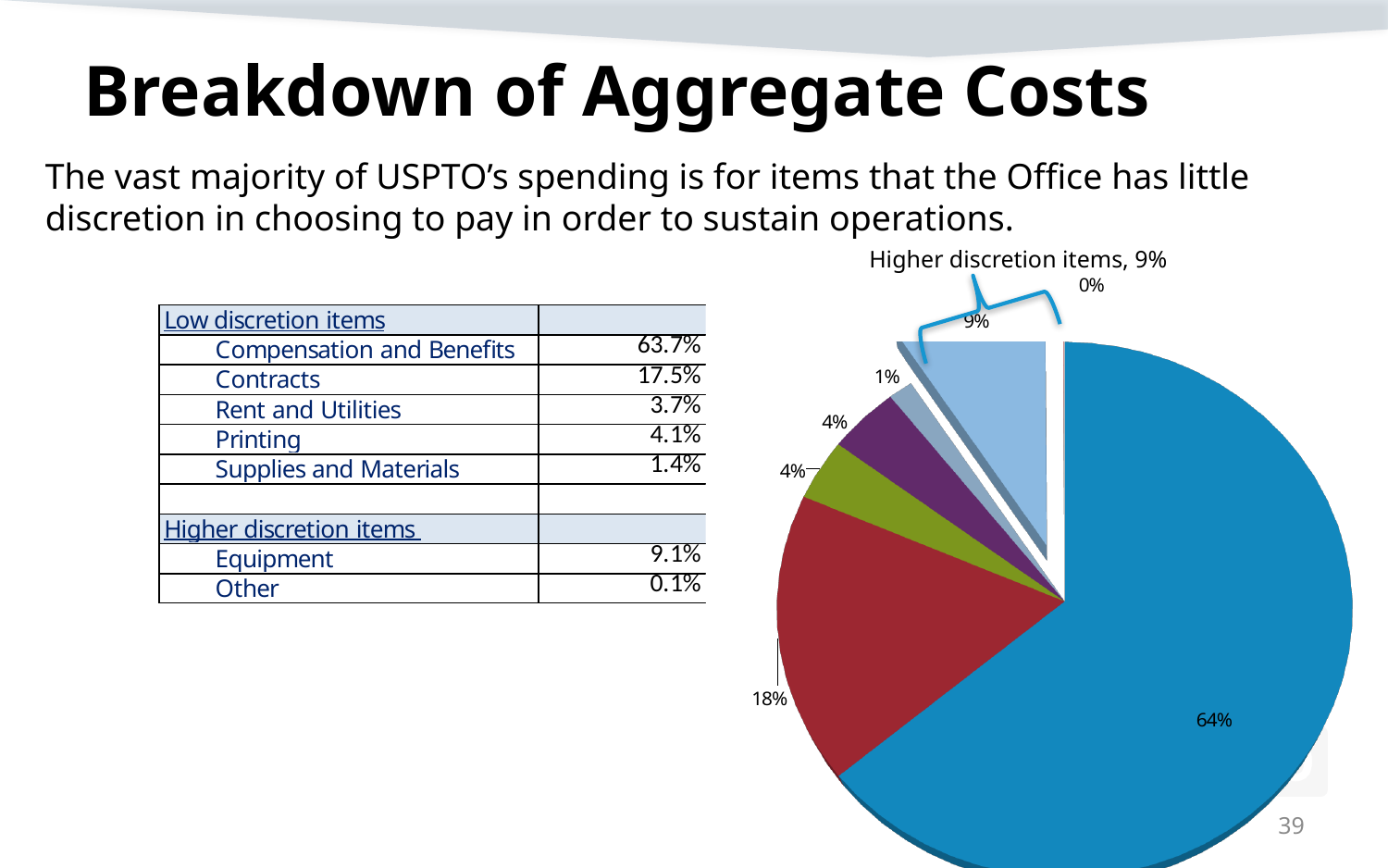
What is the value of the smallest slice in the pie chart? 0% How many slices does the pie chart have? 7 According to the table, what percentage of costs is Supplies and Materials? 1.4% What is the value of the largest slice in the pie chart? 64% What percentage is shown in the callout label for Higher discretion items on the pie chart? 9% What kind of chart is shown on the right of the slide? pie chart According to the table, what percentage of costs is Contracts? 17.5% What share of the pie does the second-largest slice represent? 18% According to the table, what is the combined percentage of the Higher discretion items (Equipment and Other)? 9.2% According to the table, what percentage of costs is Compensation and Benefits? 63.7% According to the table, which is larger: Printing or Rent and Utilities? Printing What is the difference between the largest slice (64%) and the second-largest slice (18%) in the pie chart? 46 percentage points